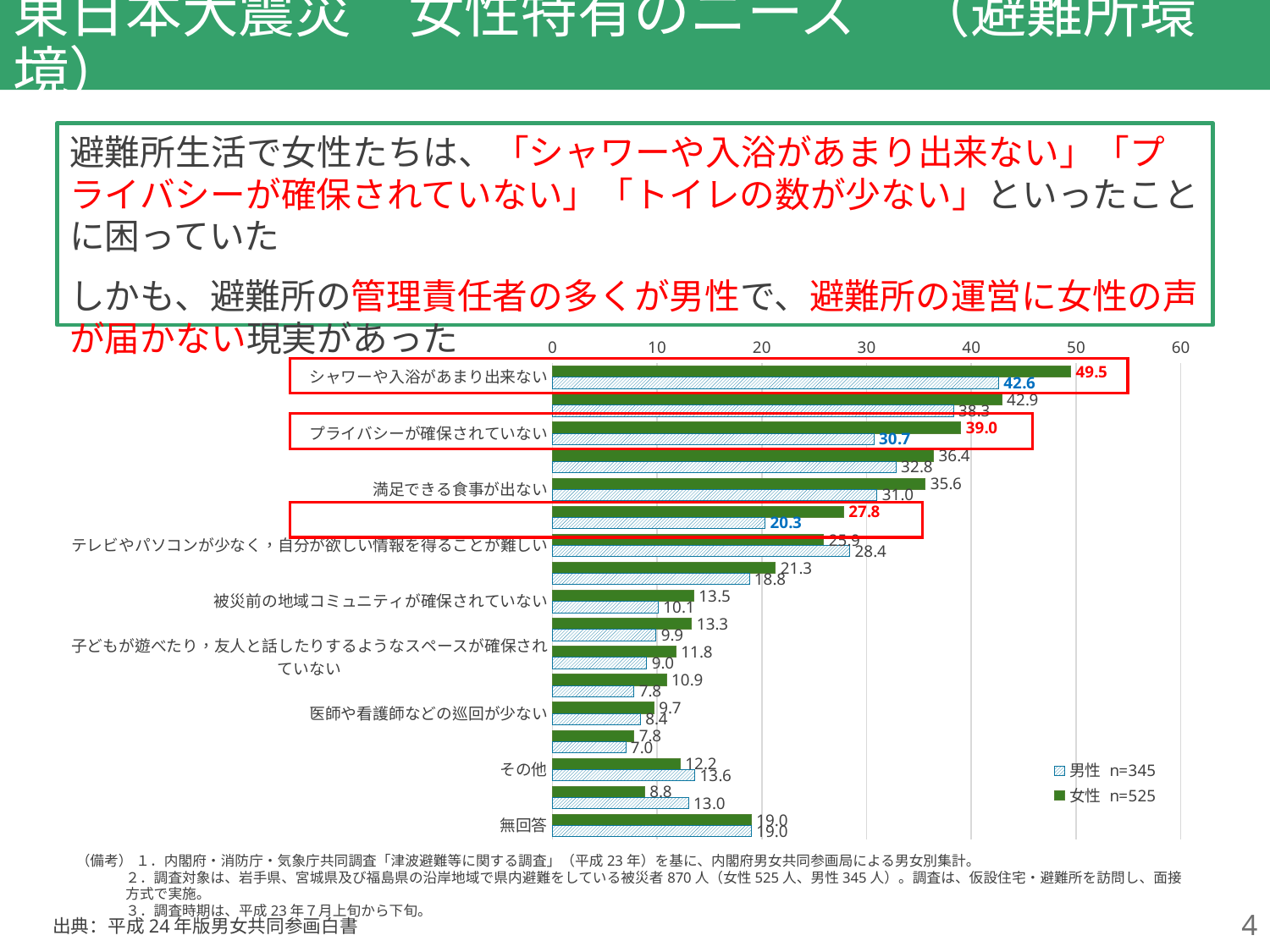
What is the value for 男性 for プライバシーが確保されていない? 30.7 What is the value for 女性 for プライバシーが確保されていない? 39.0 What is the value for 女性 for シャワーや入浴があまり出来ない? 49.5 What kind of chart is shown on the slide? Bar chart How many series does the legend list? 2 For テレビやパソコンが少なく，自分が欲しい情報を得ることが難しい, which series has the larger value, 男性 or 女性? 男性 Which category has the highest value for 女性? シャワーや入浴があまり出来ない What is the difference between the 女性 and 男性 values for プライバシーが確保されていない? 8.3 What is the value for 男性 for シャワーや入浴があまり出来ない? 42.6 According to the legend, what is the sample size (n) for 男性? 345 What is the difference between the 女性 and 男性 values for シャワーや入浴があまり出来ない? 6.9 What is the value for 男性 for その他? 13.6